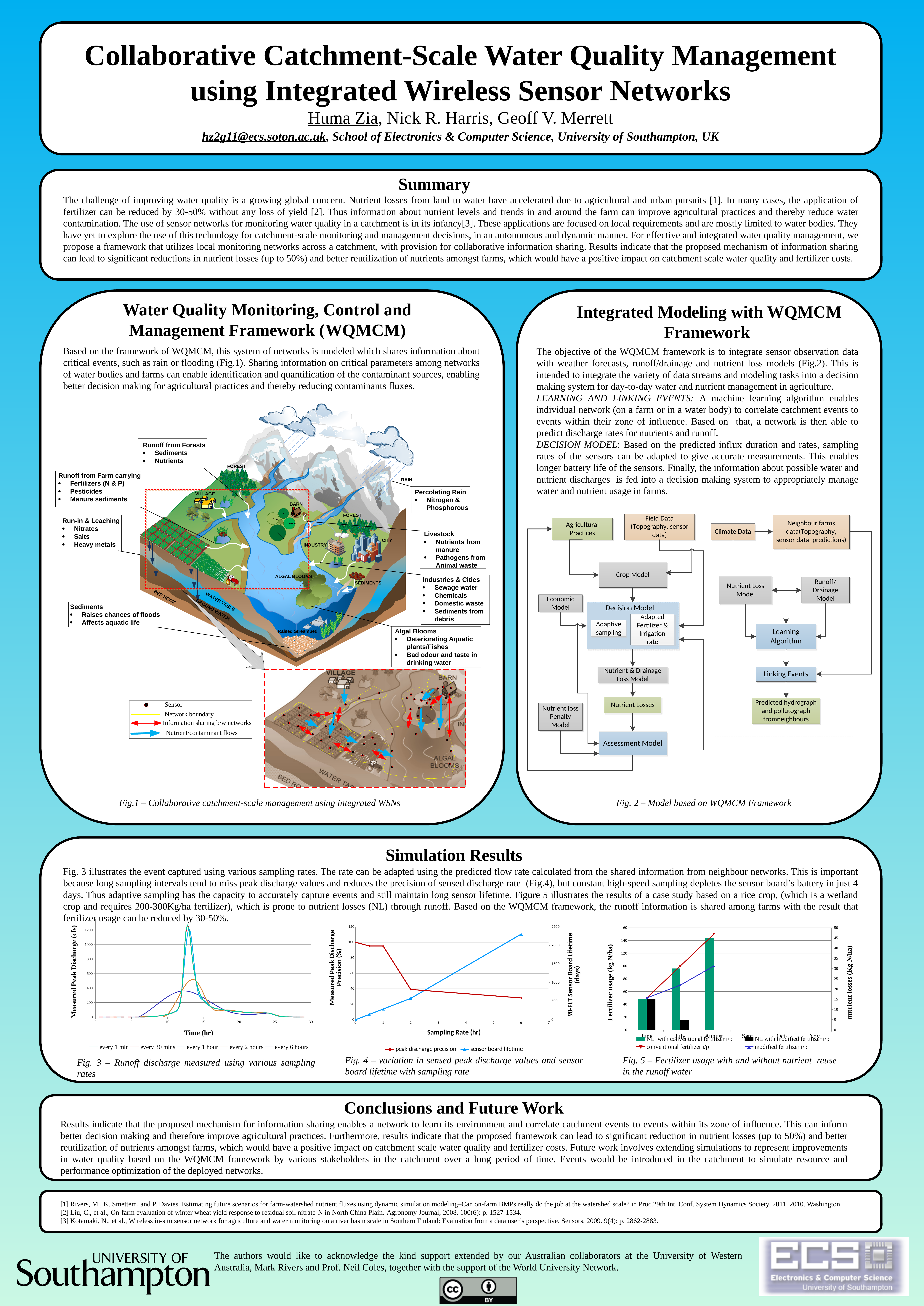
In Fig. 5, in which month is the 'NL with conventional fertilizer i/p' bar highest? August In Fig. 4, does the peak discharge precision rise or fall as the sampling rate increases? fall In Fig. 4, does the sensor board lifetime rise or fall as the sampling rate increases? rise In Fig. 3, how many series does the legend list? 5 In Fig. 3, is the peak value of the 'every 6 hours' series greater or less than 400? less In Fig. 4, is the sensor board lifetime at a sampling rate of 6 hr greater or less than 2000 days? greater In Fig. 3, what is the label of the x axis? Time (hr) In Fig. 5, how many series does the legend list? 4 What kind of chart is Fig. 3 – Runoff discharge measured using various sampling rates? line chart In Fig. 4, how many series does the legend list? 2